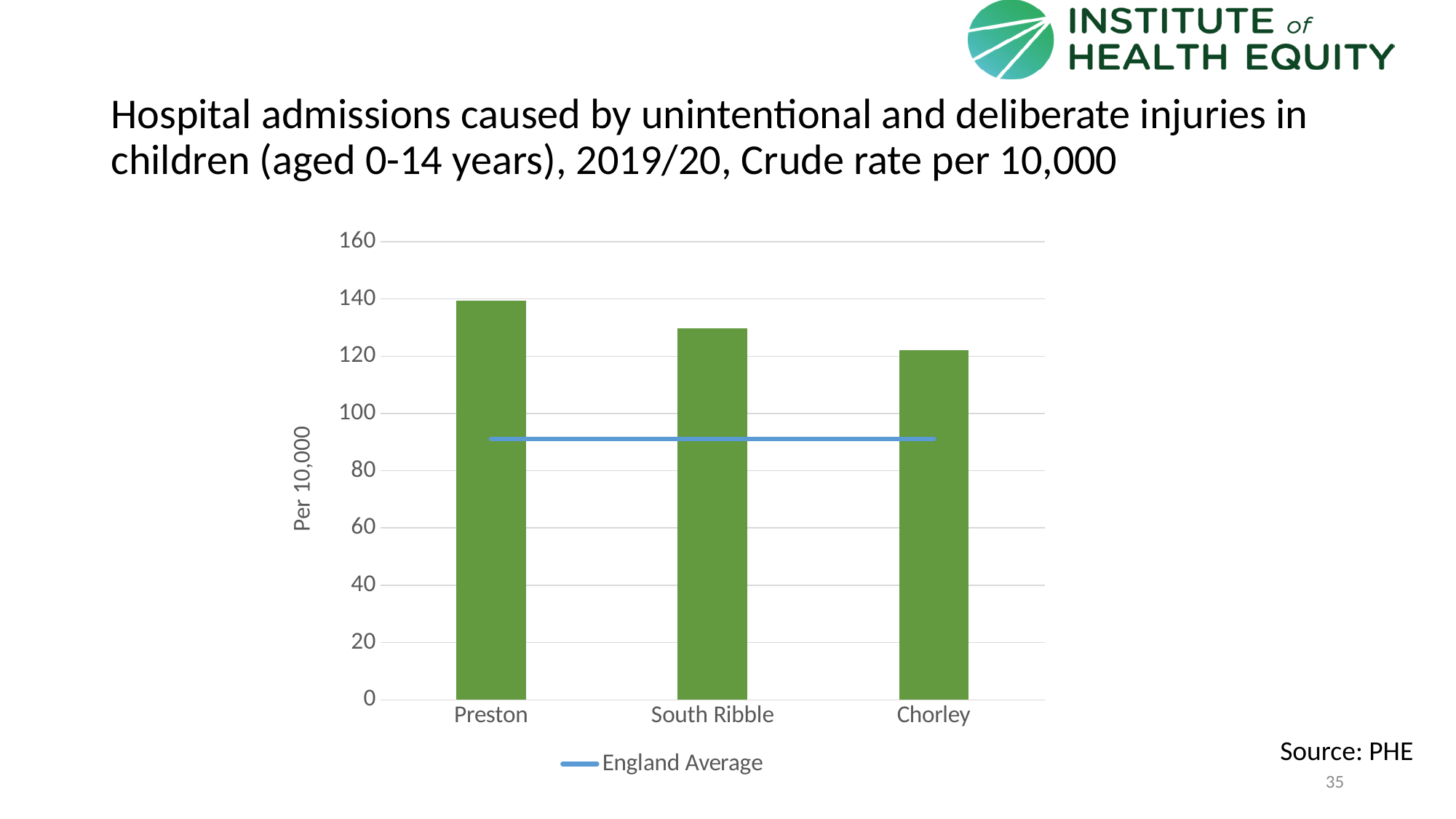
Which has a higher rate, Preston or Chorley? Preston What entry does the chart legend list? England Average Is the value for Chorley greater or less than 140? less Which area has the highest rate of hospital admissions for injuries in children? Preston Which has a higher rate, South Ribble or Chorley? South Ribble What is the label on the vertical axis of the chart? Per 10,000 What kind of chart is shown on the slide? Bar chart Which area has the lowest rate of hospital admissions for injuries in children? Chorley Is the value for Preston greater or less than 120? greater Is the England Average line greater or less than 100? less Do the bar values rise or fall moving from Preston to Chorley along the x axis? Fall How many local areas are shown on the x axis of the chart? 3